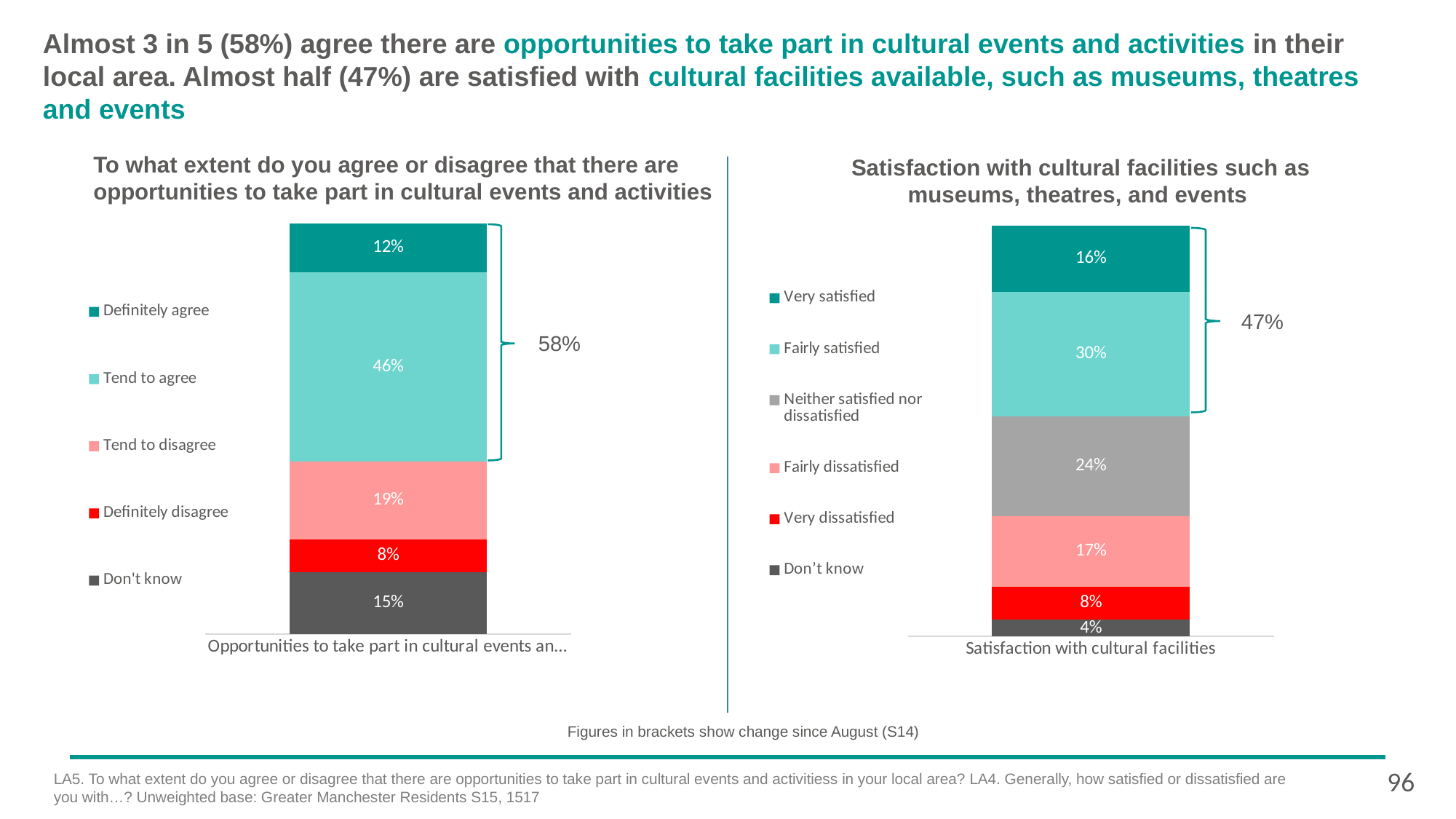
In the right chart on satisfaction with cultural facilities, which response category has the smallest share? Don't know How many response categories does the legend of the left chart on opportunities to take part in cultural events list? 5 What type of chart is used on the left to show agreement about opportunities to take part in cultural events? Stacked bar chart In the right chart on satisfaction with cultural facilities, what percentage is shown for 'Very dissatisfied'? 8% In the right chart on satisfaction with cultural facilities, what percentage is shown for 'Neither satisfied nor dissatisfied'? 24% How many response categories does the legend of the right chart on satisfaction with cultural facilities list? 6 In the right chart on satisfaction with cultural facilities, which is larger: 'Fairly satisfied' or 'Neither satisfied nor dissatisfied'? Fairly satisfied In the left chart on opportunities to take part in cultural events, what is the difference between 'Tend to agree' and 'Tend to disagree'? 27% In the left chart on opportunities to take part in cultural events, what percentage is shown for 'Tend to agree'? 46% In the right chart on satisfaction with cultural facilities, what combined percentage is shown by the bracket for 'Very satisfied' and 'Fairly satisfied'? 47% In the left chart on opportunities to take part in cultural events, what percentage is shown for 'Don't know'? 15% In the left chart on opportunities to take part in cultural events, which response category has the largest share? Tend to agree